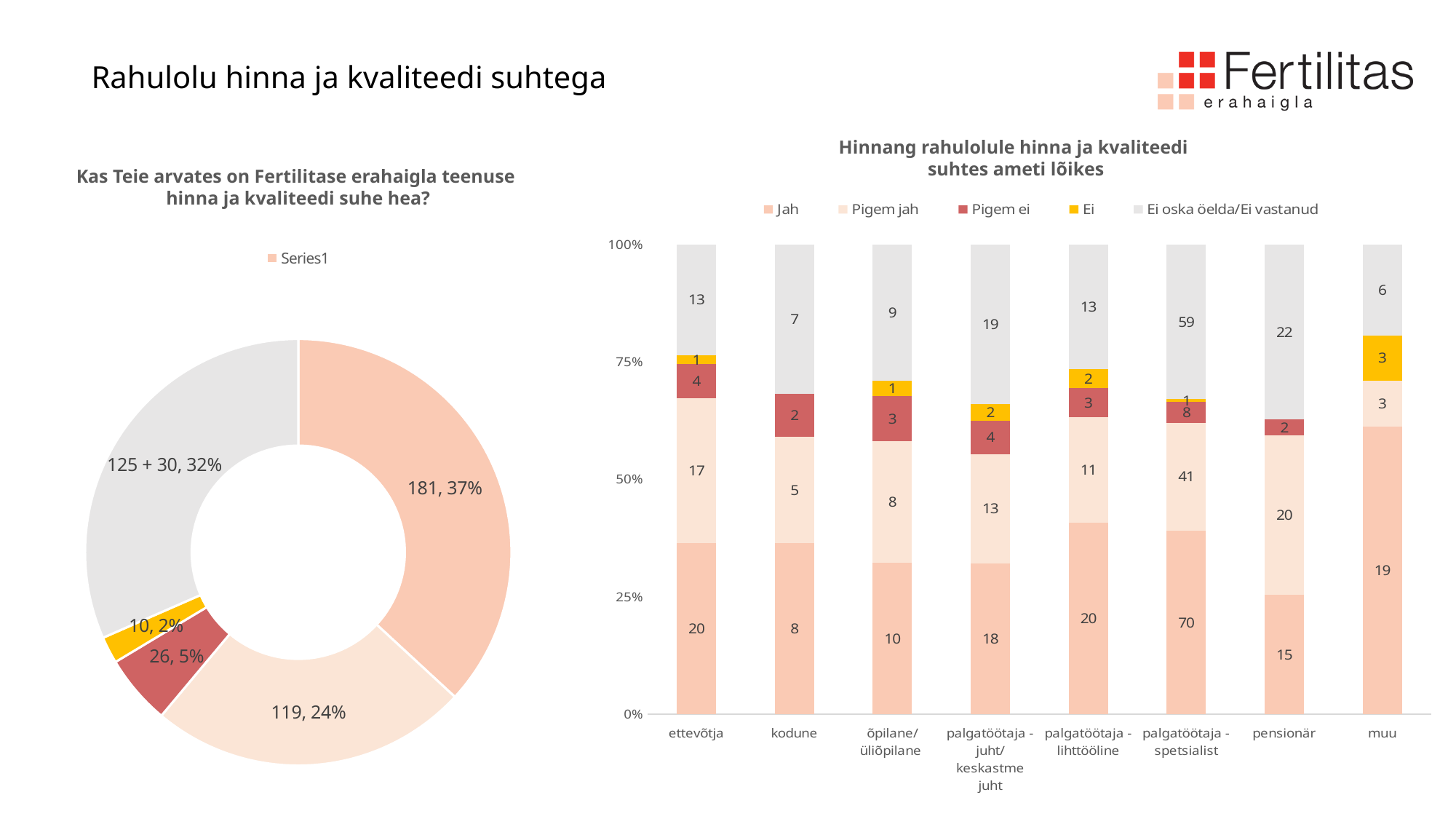
In the chart 'Hinnang rahulolule hinna ja kvaliteedi suhtes ameti lõikes', how many series does the legend list? 5 In the chart 'Hinnang rahulolule hinna ja kvaliteedi suhtes ameti lõikes', which occupation category has the lowest 'Jah' value? kodune In the chart 'Hinnang rahulolule hinna ja kvaliteedi suhtes ameti lõikes', what is the total of the labelled values in the ettevõtja bar? 55 What kind of chart is 'Hinnang rahulolule hinna ja kvaliteedi suhtes ameti lõikes'? Stacked bar chart In the chart 'Hinnang rahulolule hinna ja kvaliteedi suhtes ameti lõikes', which is larger: the 'Pigem jah' value for pensionär or for palgatöötaja - lihttööline? pensionär In the chart 'Hinnang rahulolule hinna ja kvaliteedi suhtes ameti lõikes', what is the 'Jah' value for palgatöötaja - spetsialist? 70 In the chart 'Hinnang rahulolule hinna ja kvaliteedi suhtes ameti lõikes', what is the difference between the 'Jah' values for palgatöötaja - spetsialist and pensionär? 55 In the chart 'Hinnang rahulolule hinna ja kvaliteedi suhtes ameti lõikes', how many occupation categories are shown on the x axis? 8 In the chart 'Hinnang rahulolule hinna ja kvaliteedi suhtes ameti lõikes', what is the 'Ei oska öelda/Ei vastanud' value for pensionär? 22 In the chart 'Hinnang rahulolule hinna ja kvaliteedi suhtes ameti lõikes', what is the 'Pigem jah' value for ettevõtja? 17 In the donut chart on the left, what share of the whole does the largest slice (181) represent? 37% In the chart 'Hinnang rahulolule hinna ja kvaliteedi suhtes ameti lõikes', which occupation category has the highest 'Jah' value? palgatöötaja - spetsialist